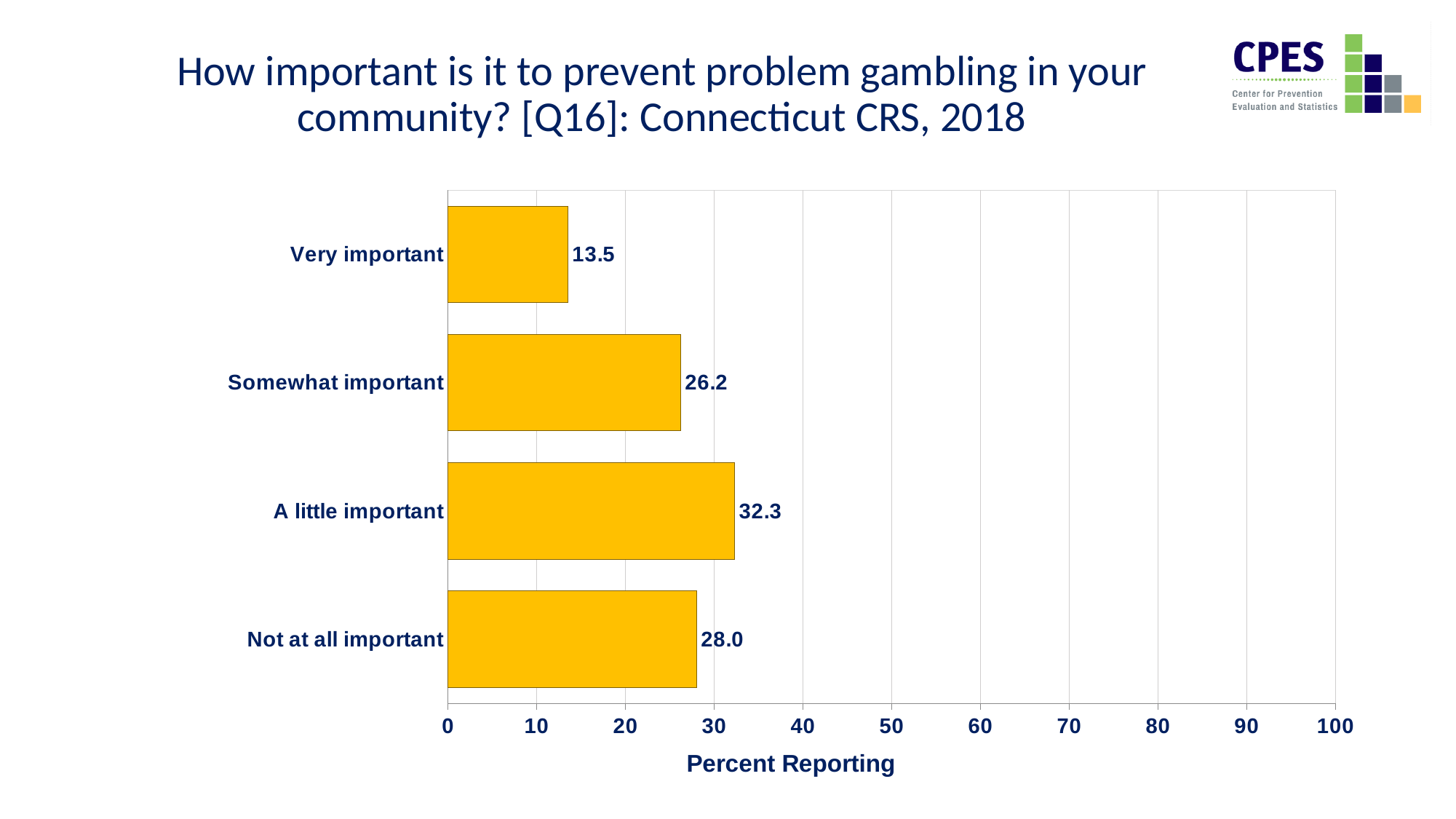
Which category has the highest percent reporting? A little important Is the value for 'Somewhat important' greater or less than 30? less What percent reported 'A little important'? 32.3 Which is larger, 'Not at all important' or 'Somewhat important'? Not at all important What percent reported 'Somewhat important'? 26.2 How many categories are shown in the chart? 4 What percent reported 'Very important'? 13.5 What kind of chart is shown on the slide? bar chart What is the label of the horizontal axis? Percent Reporting Which category has the lowest percent reporting? Very important What is the difference between 'A little important' and 'Very important'? 18.8 What percent reported 'Not at all important'? 28.0